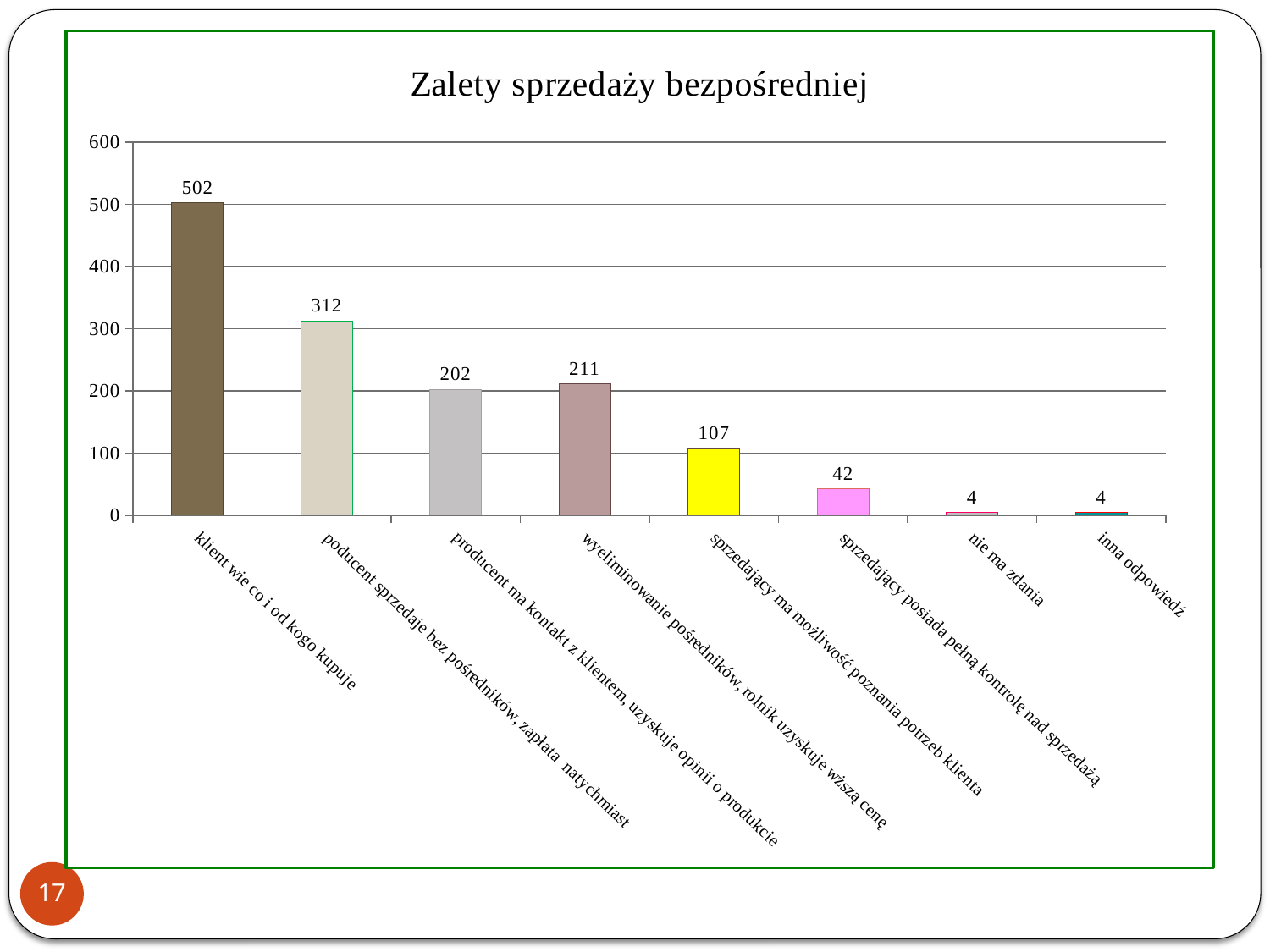
What is the title of the chart? Zalety sprzedaży bezpośredniej Which category has the highest value? klient wie co i od kogo kupuje What is the value for "sprzedający ma możliwość poznania potrzeb klienta"? 107 What is the difference between the values for "klient wie co i od kogo kupuje" and "poducent sprzedaje bez pośredników, zapłata natychmiast"? 190 What is the value for "sprzedający posiada pełną kontrolę nad sprzedażą"? 42 Which is larger: the value for "wyeliminowanie pośredników, rolnik uzyskuje wższą cenę" or the value for "producent ma kontakt z klientem, uzyskuje opinii o produkcie"? wyeliminowanie pośredników, rolnik uzyskuje wższą cenę How many categories are shown on the chart? 8 What is the value for "klient wie co i od kogo kupuje"? 502 Is the value for "poducent sprzedaje bez pośredników, zapłata natychmiast" greater or less than 300? greater What kind of chart is shown on the slide? bar chart What is the difference between the values for "wyeliminowanie pośredników, rolnik uzyskuje wższą cenę" and "producent ma kontakt z klientem, uzyskuje opinii o produkcie"? 9 What is the value for "nie ma zdania"? 4